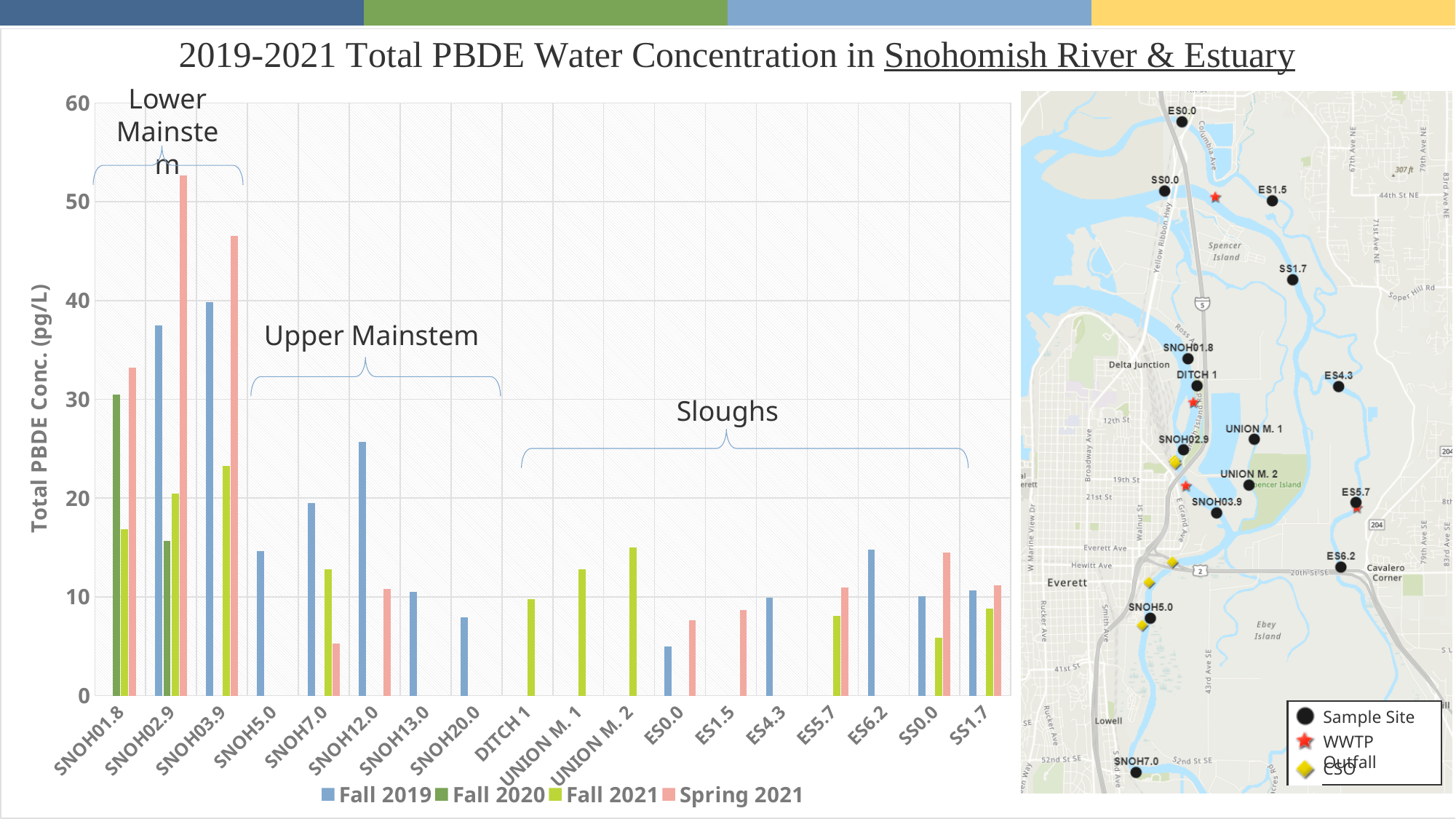
At SNOH01.8, which is larger: the Spring 2021 value or the Fall 2021 value? Spring 2021 Is the Fall 2021 value for SNOH01.8 greater or less than 20? less What kind of chart is shown on the slide? bar chart Which sample site has the highest Spring 2021 value? SNOH02.9 What is the label of the chart's y axis? Total PBDE Conc. (pg/L) Is the Spring 2021 value for SNOH02.9 greater or less than 50? greater Which sample site has the highest Fall 2019 value? SNOH03.9 Which sample site has the lowest Fall 2019 value? ES0.0 How many sample site categories are shown along the x axis of the chart? 18 Is the Spring 2021 value for SNOH7.0 greater or less than 10? less How many series does the chart legend list? 4